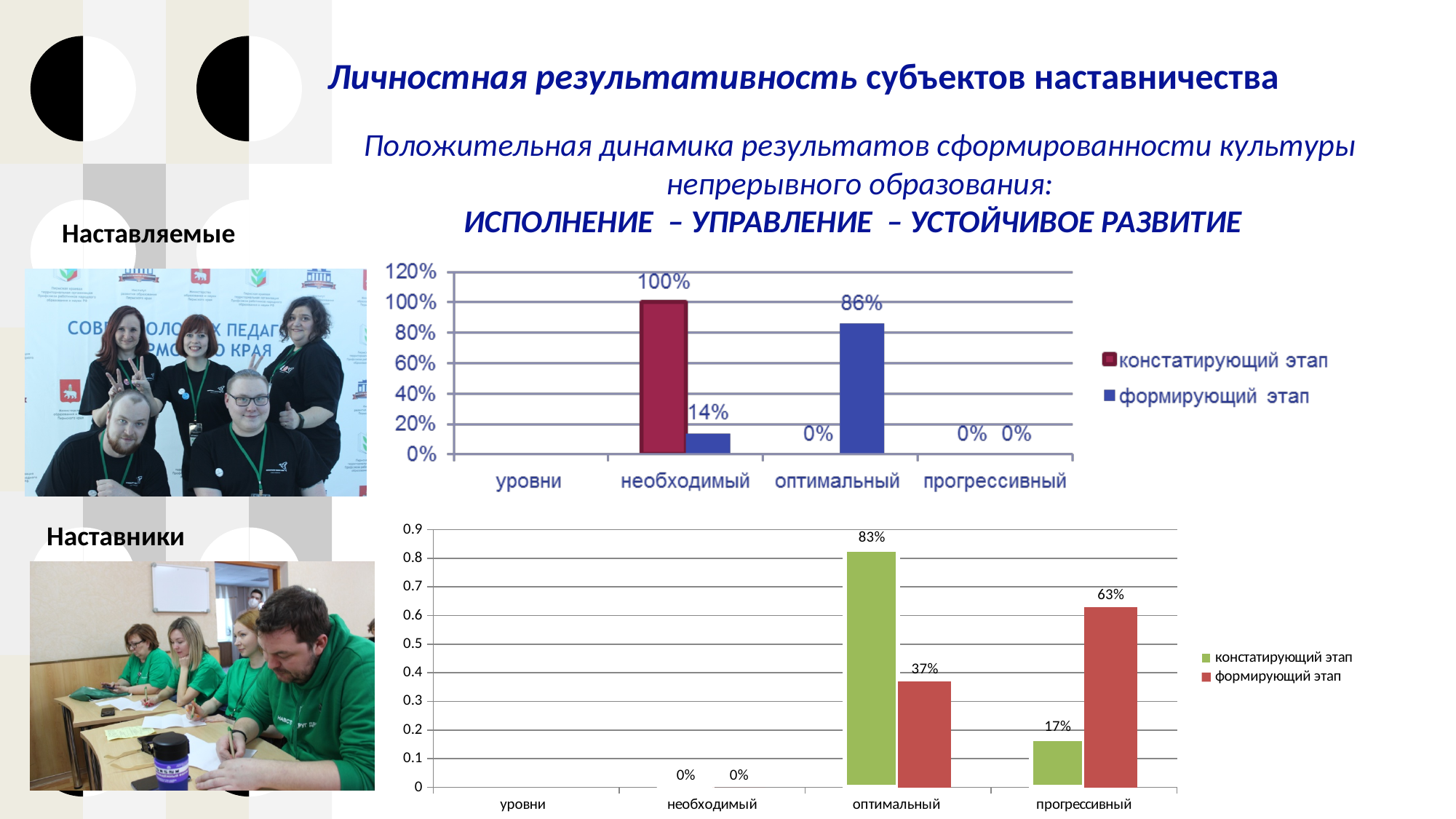
In the bottom chart, what is the value for прогрессивный in the констатирующий этап series? 17% In the bottom chart, what is the difference between the формирующий этап and констатирующий этап values for прогрессивный? 46% In the bottom chart, what is the value for оптимальный in the констатирующий этап series? 83% In the top chart, how many series does the legend list? 2 In the bottom chart, which is larger for оптимальный: the констатирующий этап value or the формирующий этап value? констатирующий этап In the top chart, what is the difference between the констатирующий этап and формирующий этап values for необходимый? 86% In the bottom chart, what is the value for прогрессивный in the формирующий этап series? 63% In the top chart, what is the value for необходимый in the констатирующий этап series? 100% What kind of chart is the bottom chart? Bar chart In the top chart, what is the value for необходимый in the формирующий этап series? 14% In the bottom chart, which category has the highest формирующий этап value? прогрессивный In the top chart, what is the value for оптимальный in the формирующий этап series? 86%